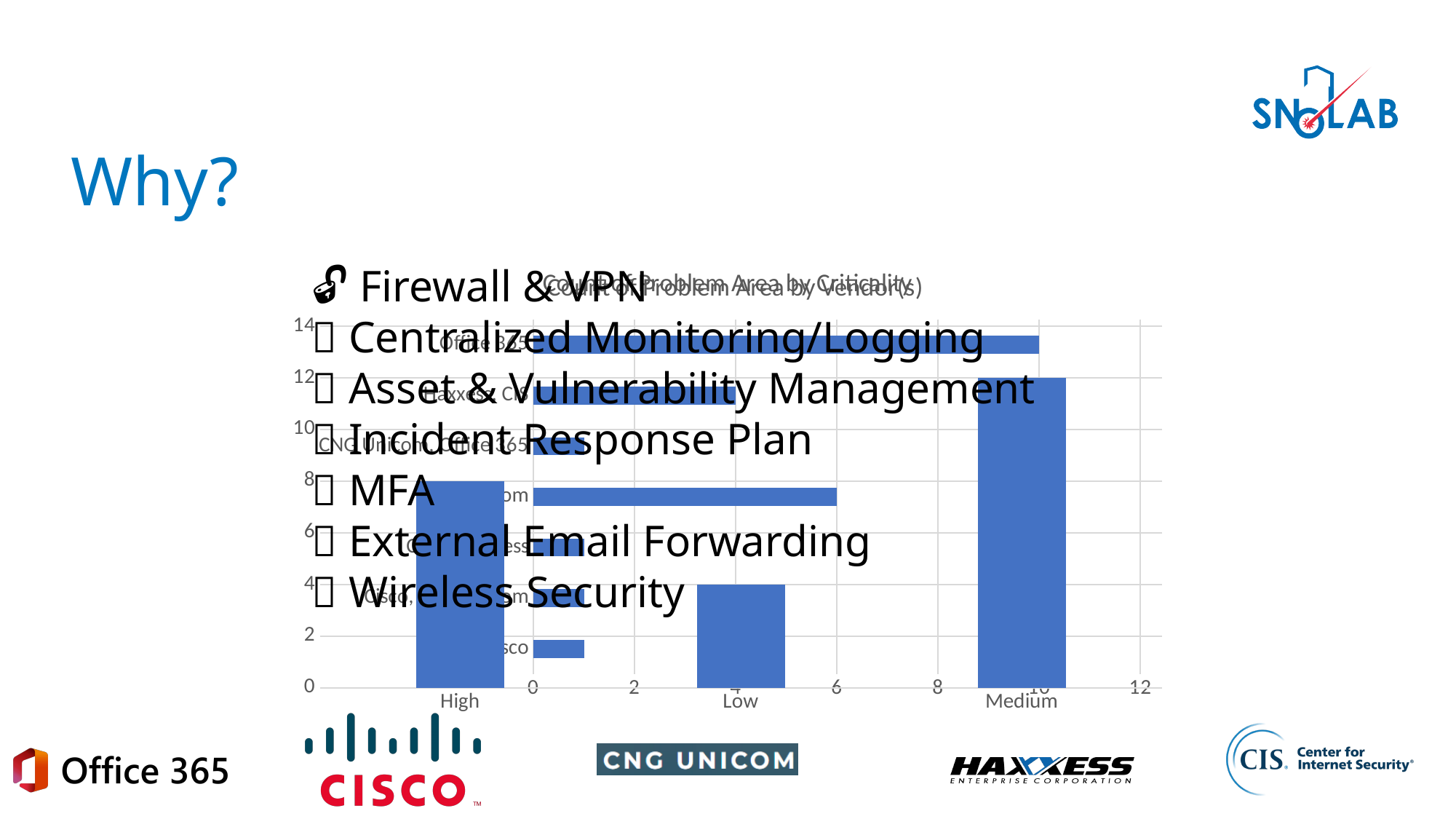
On the 'Count of Problem Area by Criticality' chart, what is the difference between the Medium and Low counts? 8 On the 'Count of Problem Area by Criticality' chart, which criticality level has the highest count? Medium On the 'Count of Problem Area by Criticality' chart, which criticality level has the lowest count? Low On the 'Count of Problem Area by Vendor(s)' chart, what is the value for Office 365? 10 On the 'Count of Problem Area by Criticality' chart, what is the value for Medium? 12 On the 'Count of Problem Area by Vendor(s)' chart, is the value for Office 365 greater or less than 8? greater On the 'Count of Problem Area by Vendor(s)' chart, is the value for Cisco greater or less than 2? less On the 'Count of Problem Area by Criticality' chart, what is the value for High? 8 On the 'Count of Problem Area by Criticality' chart, which is larger, High or Low? High What kind of chart is the 'Count of Problem Area by Criticality' chart? Bar chart On the 'Count of Problem Area by Criticality' chart, what is the value for Low? 4 On the 'Count of Problem Area by Criticality' chart, how many criticality categories are shown? 3